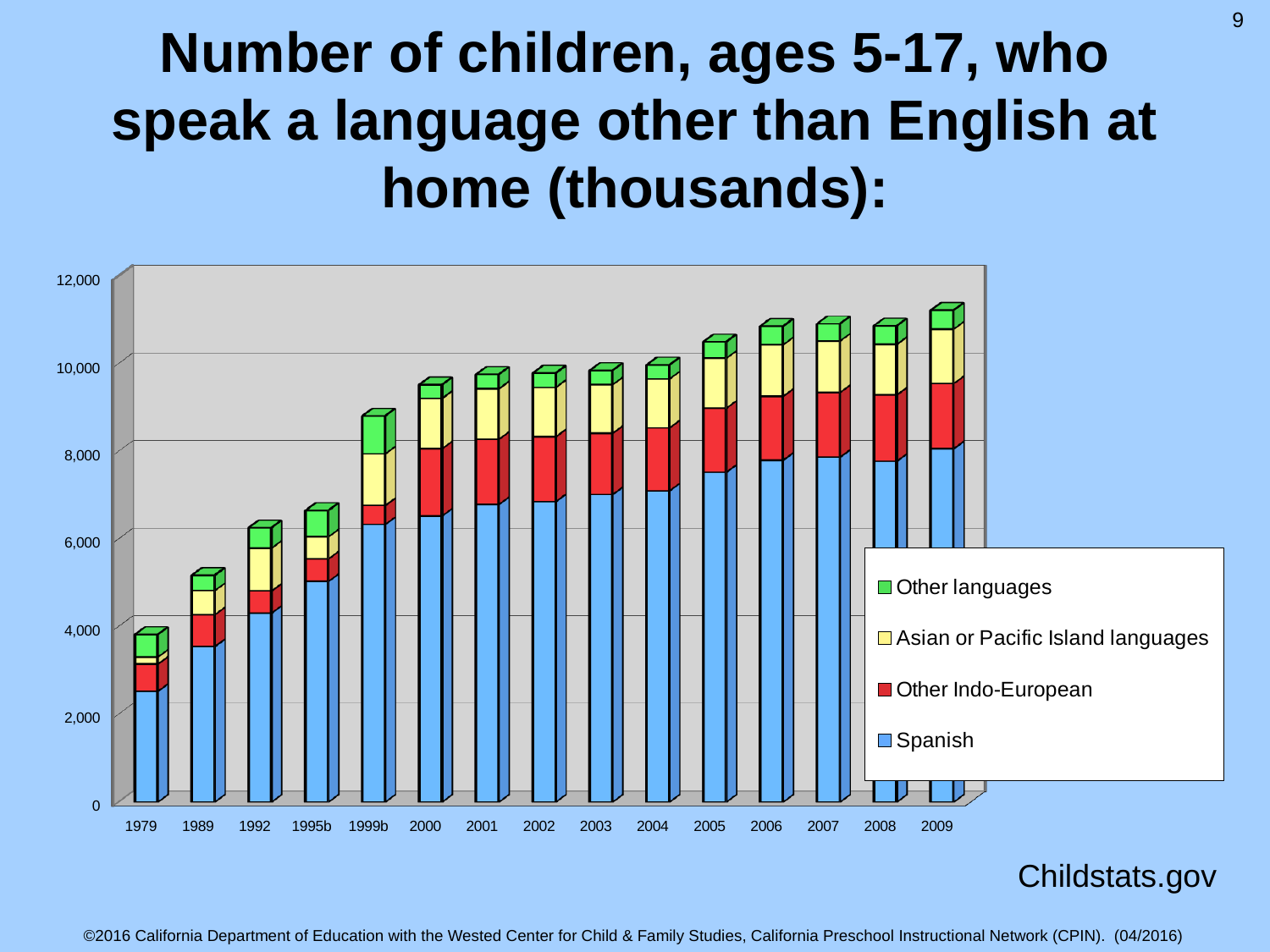
How many series does the chart's legend list? 4 What kind of chart is shown on the slide? Stacked bar chart Is the total value for 1989 greater or less than 4,000? greater Which year has the shortest stacked bar (smallest total number of children)? 1979 Which series is shown in blue in the chart? Spanish Do the total bar heights generally rise or fall from 1979 to 2009? Rise Is the total value for 1992 greater or less than 8,000? less Is the total value for 2009 greater or less than 10,000? greater What source is cited below the chart? Childstats.gov Which year has the tallest stacked bar (largest total number of children)? 2009 How many years (categories) are shown along the x axis of the chart? 15